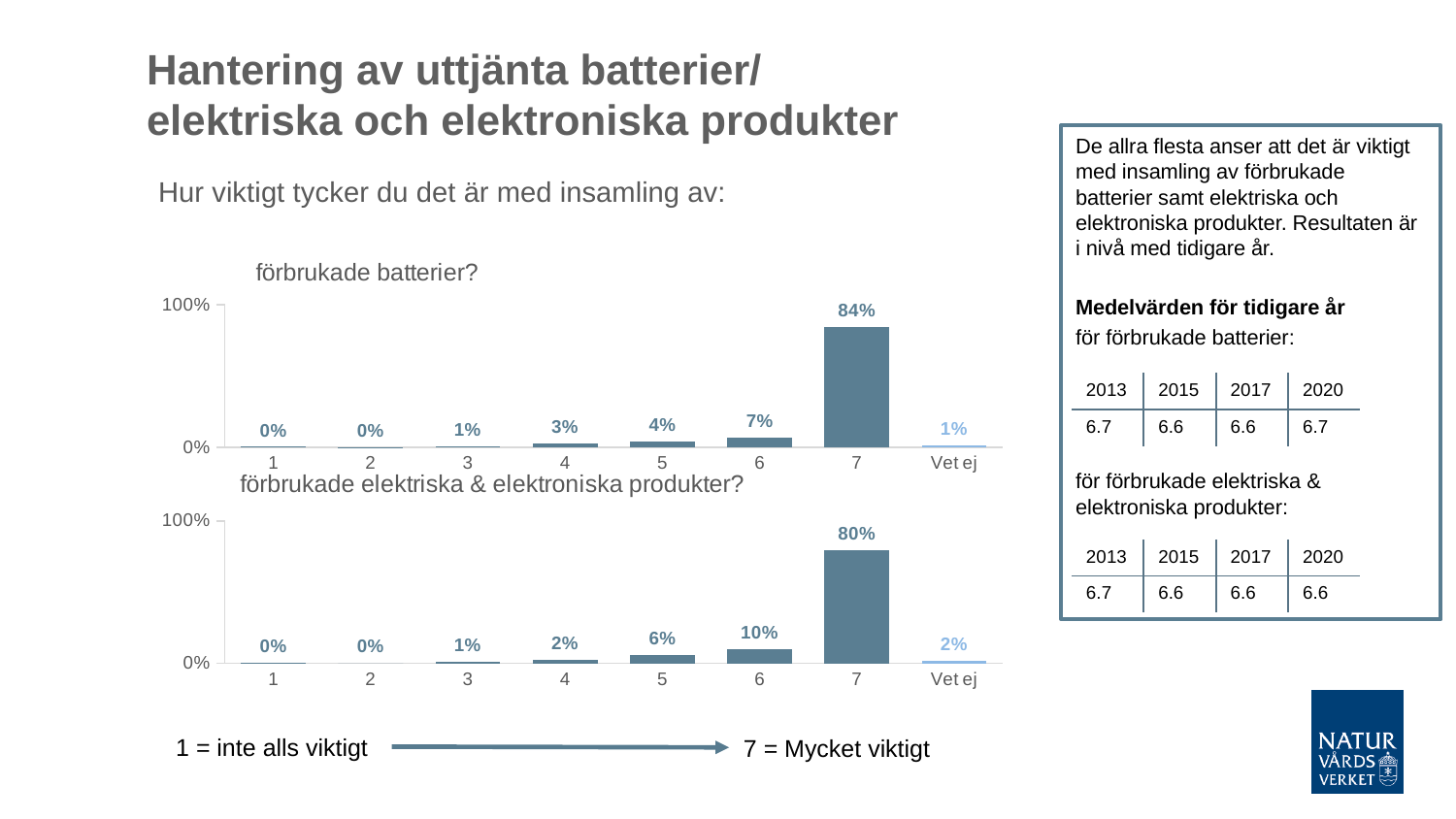
In the 'förbrukade elektriska & elektroniska produkter?' chart, is the value for category 6 larger than the value for category 5? Yes In the 'förbrukade batterier?' chart, what is the value for category 6? 7% In the 'förbrukade batterier?' chart, do the values rise or fall from category 1 to category 7? Rise In the 'förbrukade elektriska & elektroniska produkter?' chart, what is the value for category 7? 80% In the 'förbrukade batterier?' chart, what is the value for category 7? 84% In the 'förbrukade batterier?' chart, which category has the highest value? 7 In the 'förbrukade elektriska & elektroniska produkter?' chart, what is the value for 'Vet ej'? 2% In the 'förbrukade elektriska & elektroniska produkter?' chart, what is the difference between the values for category 7 and category 6? 70% In the 'förbrukade batterier?' chart, what is the difference between the values for category 5 and category 4? 1% What kind of chart is the 'förbrukade elektriska & elektroniska produkter?' chart? Bar chart Which is larger: the value for category 7 in the 'förbrukade batterier?' chart or the value for category 7 in the 'förbrukade elektriska & elektroniska produkter?' chart? förbrukade batterier? How many categories are shown on the x axis of the 'förbrukade batterier?' chart? 8